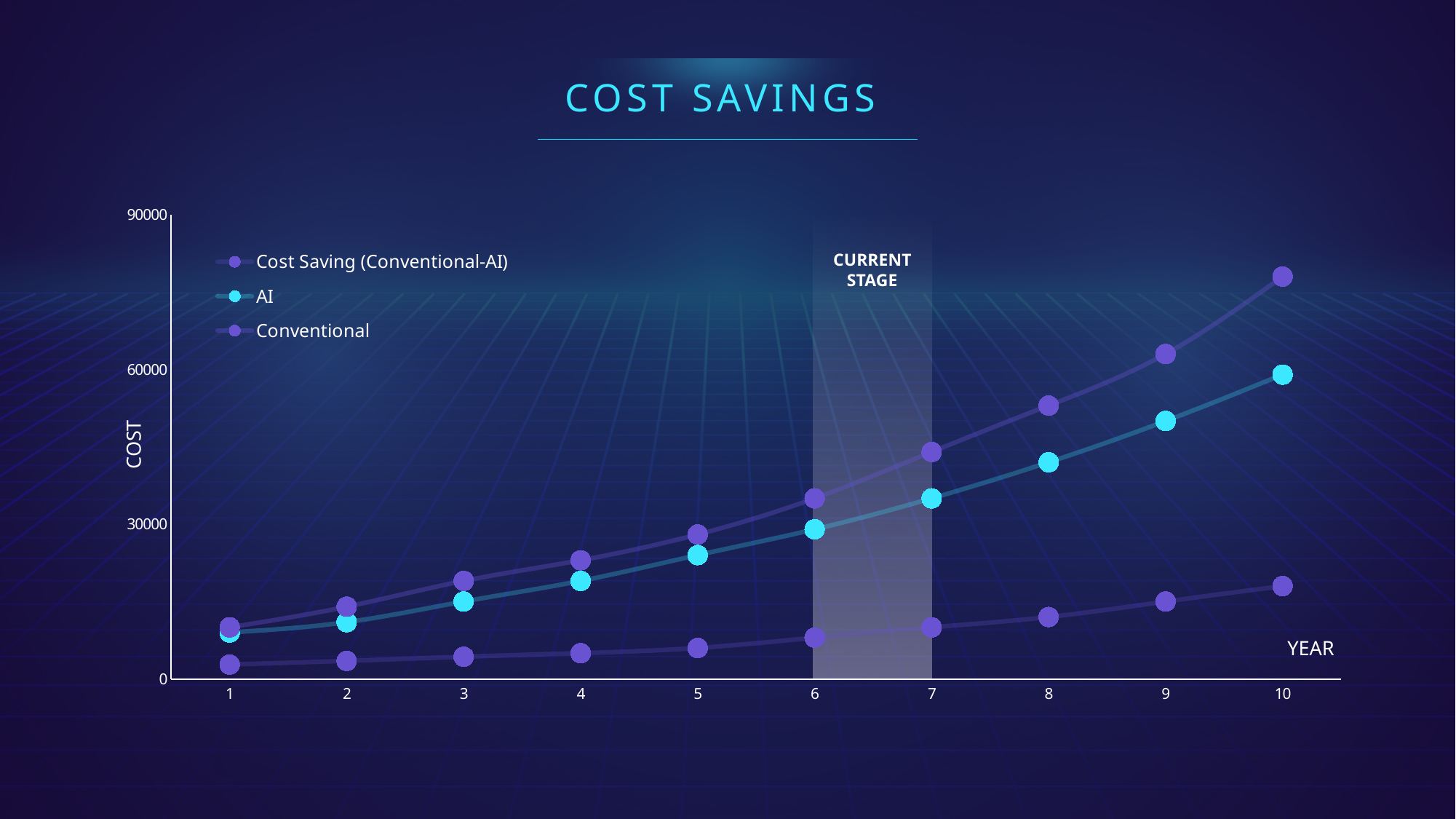
Is the AI value at year 8 greater or less than 30000? greater How many years are plotted along the x axis? 10 Is the AI value at year 1 greater or less than 30000? less Is the AI value at year 9 greater or less than 60000? less In which year is the AI series at its highest? 10 Which years does the shaded region labelled CURRENT STAGE cover? Years 6 and 7 Does the AI series rise or fall from year 1 to year 10? Rises Which is larger for the AI series: the value at year 5 or the value at year 10? Year 10 How many series does the legend list? 3 What kind of chart is shown on the slide? Line chart What is the title of the chart? COST SAVINGS